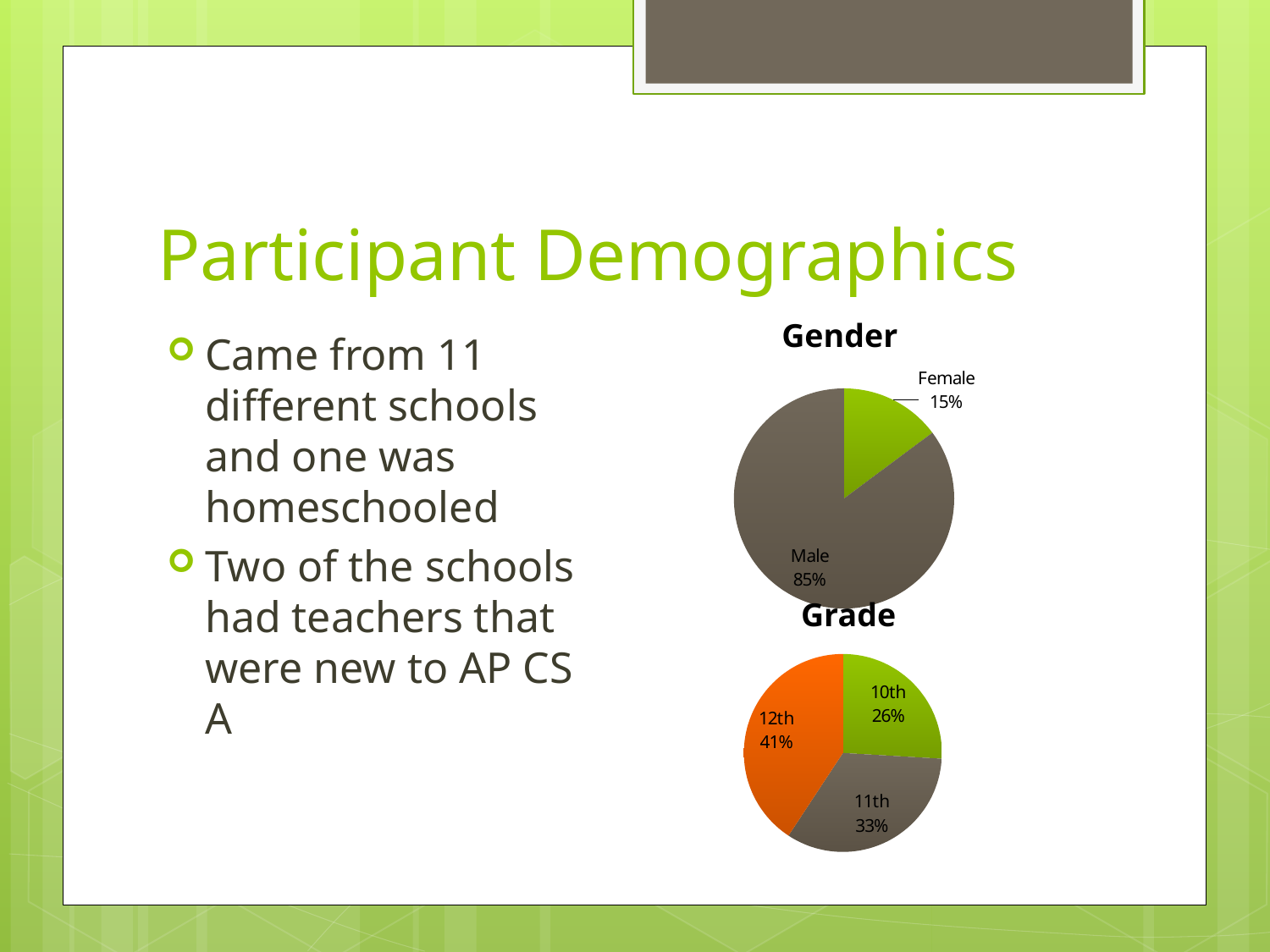
In the Grade chart, how many grade categories are shown? 3 In the Grade chart, what percentage of participants were in 10th grade? 26% In the Gender chart, which category has the largest share? Male In the Grade chart, what percentage of participants were in 11th grade? 33% In the Gender chart, what percentage of participants were Female? 15% In the Gender chart, what percentage of participants were Male? 85% In the Grade chart, which grade has the smallest share? 10th In the Grade chart, what is the difference in percentage points between 12th and 10th grade? 15 In the Grade chart, what percentage of participants were in 12th grade? 41% In the Grade chart, which grade has the largest share? 12th What kind of chart is the Gender chart? Pie chart In the Gender chart, what is the difference in percentage points between Male and Female? 70